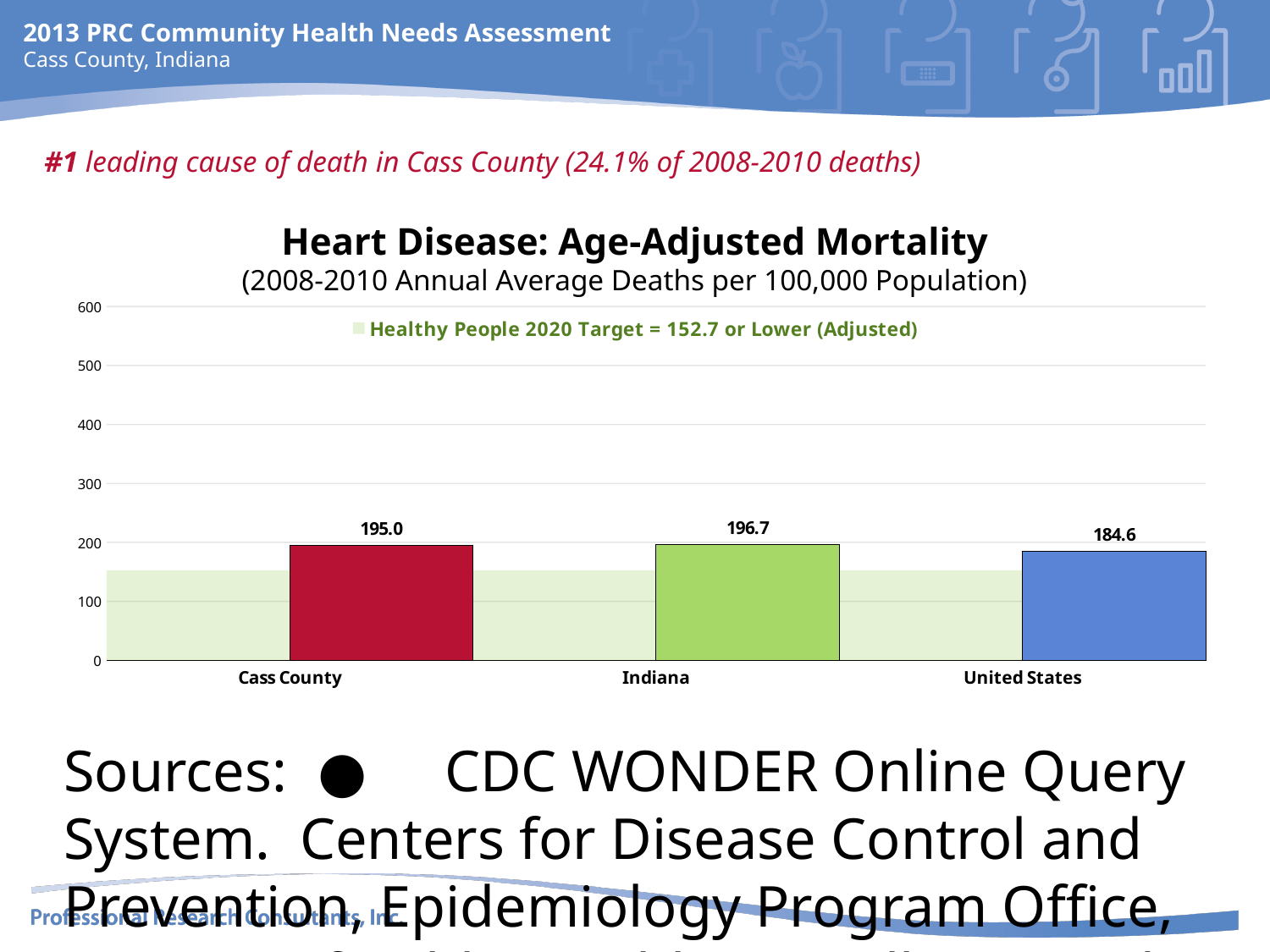
What is the difference between the Indiana and Cass County mortality rates? 1.7 What is the heart disease age-adjusted mortality rate for the United States? 184.6 Which is larger, the mortality rate for Cass County or the United States? Cass County How many categories are shown on the x axis? 3 Which category has the lowest heart disease age-adjusted mortality rate? United States Is the value for the United States greater or less than 200? less What is the difference between the Indiana and United States mortality rates? 12.1 What is the Healthy People 2020 target shown in the legend? 152.7 or Lower (Adjusted) What is the heart disease age-adjusted mortality rate for Cass County? 195.0 What is the heart disease age-adjusted mortality rate for Indiana? 196.7 What is the title of the chart? Heart Disease: Age-Adjusted Mortality What kind of chart is shown on the slide? bar chart